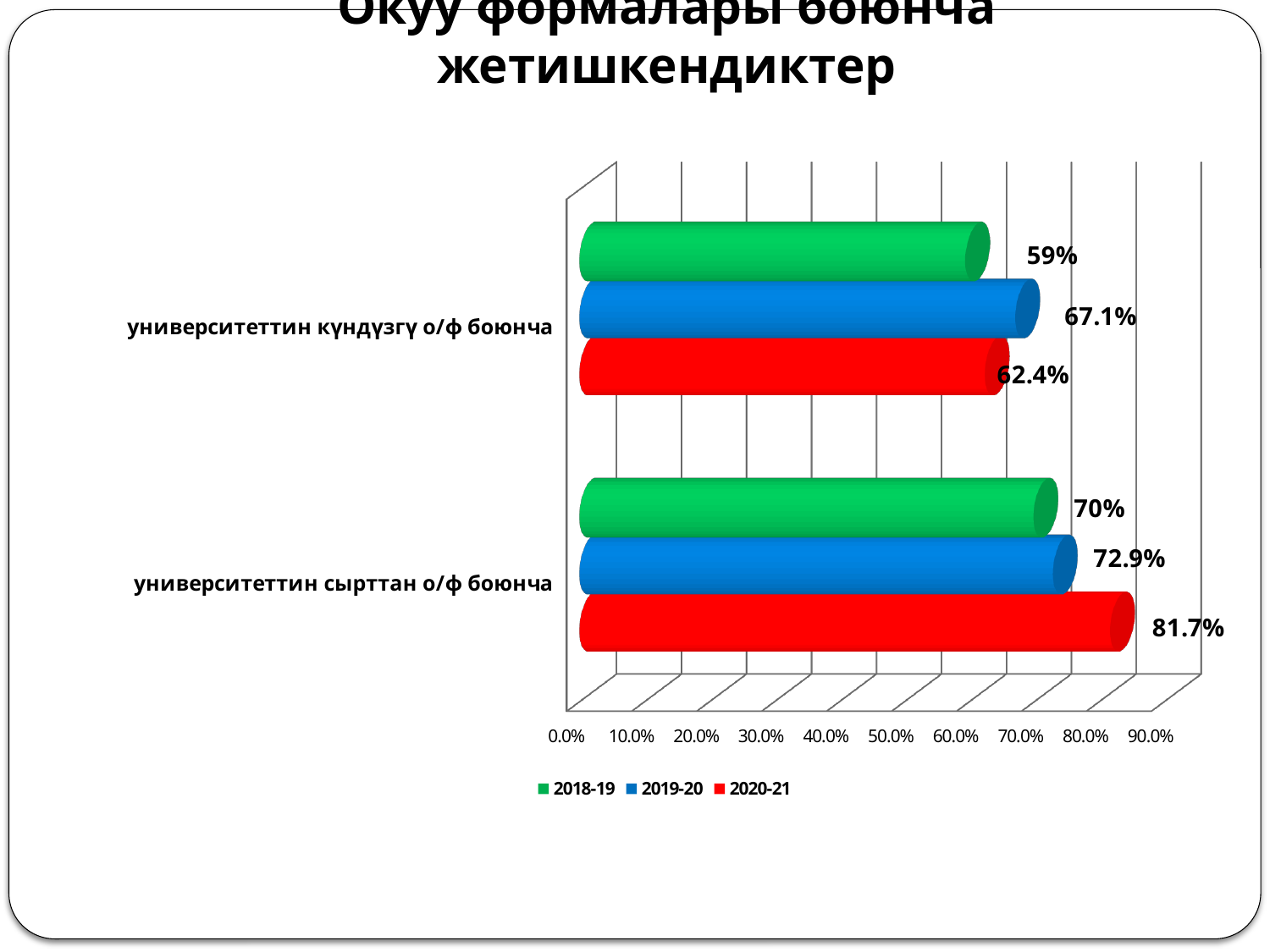
Is the 2020-21 value for "университеттин сырттан о/ф боюнча" greater or less than 80.0%? greater What is the difference between the 2020-21 values for "университеттин сырттан о/ф боюнча" and "университеттин күндүзгү о/ф боюнча"? 19.3% What kind of chart is shown on the slide? Bar chart What is the value for 2019-20 for "университеттин сырттан о/ф боюнча"? 72.9% What is the value for 2020-21 for "университеттин күндүзгү о/ф боюнча"? 62.4% Which series has the lowest value for "университеттин сырттан о/ф боюнча"? 2018-19 What is the value for 2020-21 for "университеттин сырттан о/ф боюнча"? 81.7% How many categories are shown on the chart? 2 Which is larger: the 2019-20 value for "университеттин күндүзгү о/ф боюнча" or the 2018-19 value for "университеттин сырттан о/ф боюнча"? 2018-19 value for "университеттин сырттан о/ф боюнча" How many series does the legend list? 3 Which series has the highest value for "университеттин күндүзгү о/ф боюнча"? 2019-20 What is the value for 2018-19 for "университеттин күндүзгү о/ф боюнча"? 59%